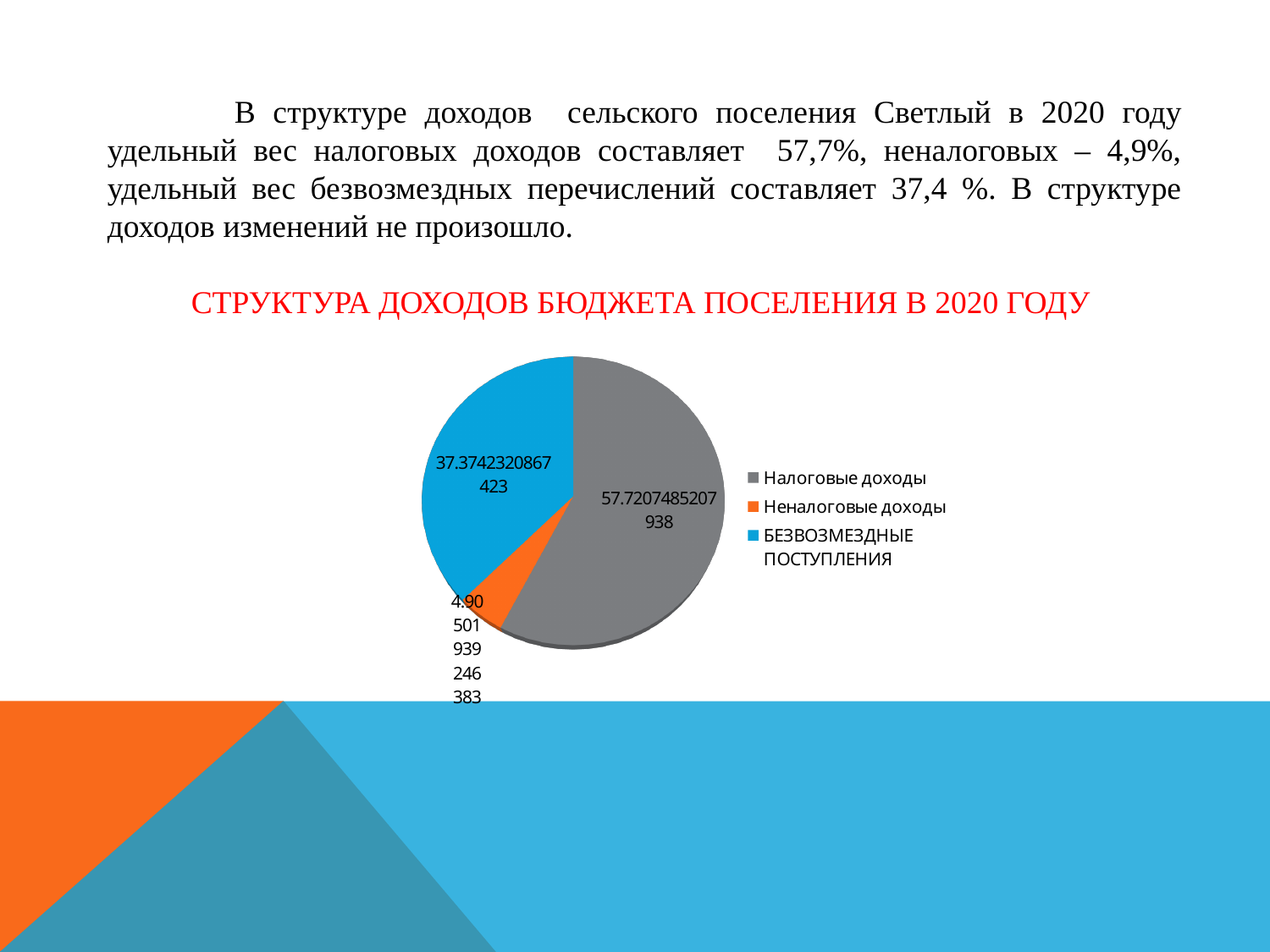
Which category has the largest slice of the pie? Налоговые доходы What kind of chart is shown on the slide? pie chart Which category has the smallest slice of the pie? Неналоговые доходы What is the value shown for БЕЗВОЗМЕЗДНЫЕ ПОСТУПЛЕНИЯ? 37.3742320867423 What is the title of the chart? СТРУКТУРА ДОХОДОВ БЮДЖЕТА ПОСЕЛЕНИЯ В 2020 ГОДУ What colour is the slice for Неналоговые доходы? orange How many slices does the pie chart have? 3 What is the value shown for Налоговые доходы? 57.7207485207938 What is the value shown for Неналоговые доходы? 4.90501939246383 What is the difference between the values for Налоговые доходы and БЕЗВОЗМЕЗДНЫЕ ПОСТУПЛЕНИЯ? 20.3465164340515 How many entries does the legend list? 3 Which is larger, the slice for БЕЗВОЗМЕЗДНЫЕ ПОСТУПЛЕНИЯ or the slice for Неналоговые доходы? БЕЗВОЗМЕЗДНЫЕ ПОСТУПЛЕНИЯ